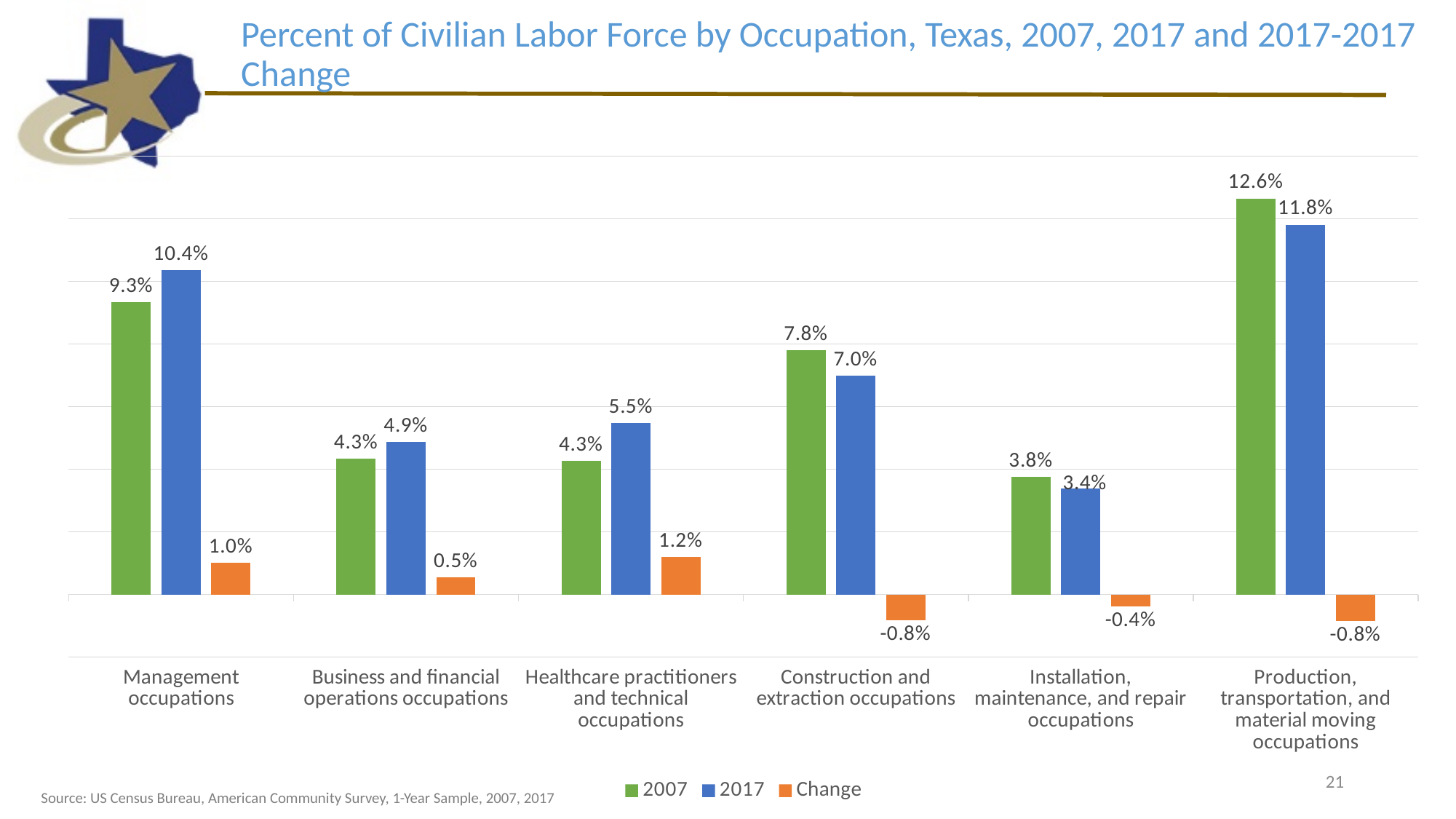
How many series does the legend list? 3 What is the difference between the 2007 and 2017 values for Healthcare practitioners and technical occupations? 1.2% What colour are the bars for the Change series? Orange What is the Change value for Installation, maintenance, and repair occupations? -0.4% Which occupation has the largest positive Change value? Healthcare practitioners and technical occupations What is the 2007 value for Construction and extraction occupations? 7.8% How many occupation categories are shown on the chart? 6 Which is larger for Construction and extraction occupations, the 2007 value or the 2017 value? 2007 Which occupation has the lowest 2007 value? Installation, maintenance, and repair occupations What is the 2017 value for Management occupations? 10.4% Which occupation has the highest 2017 value? Production, transportation, and material moving occupations What kind of chart is shown on the slide? Bar chart